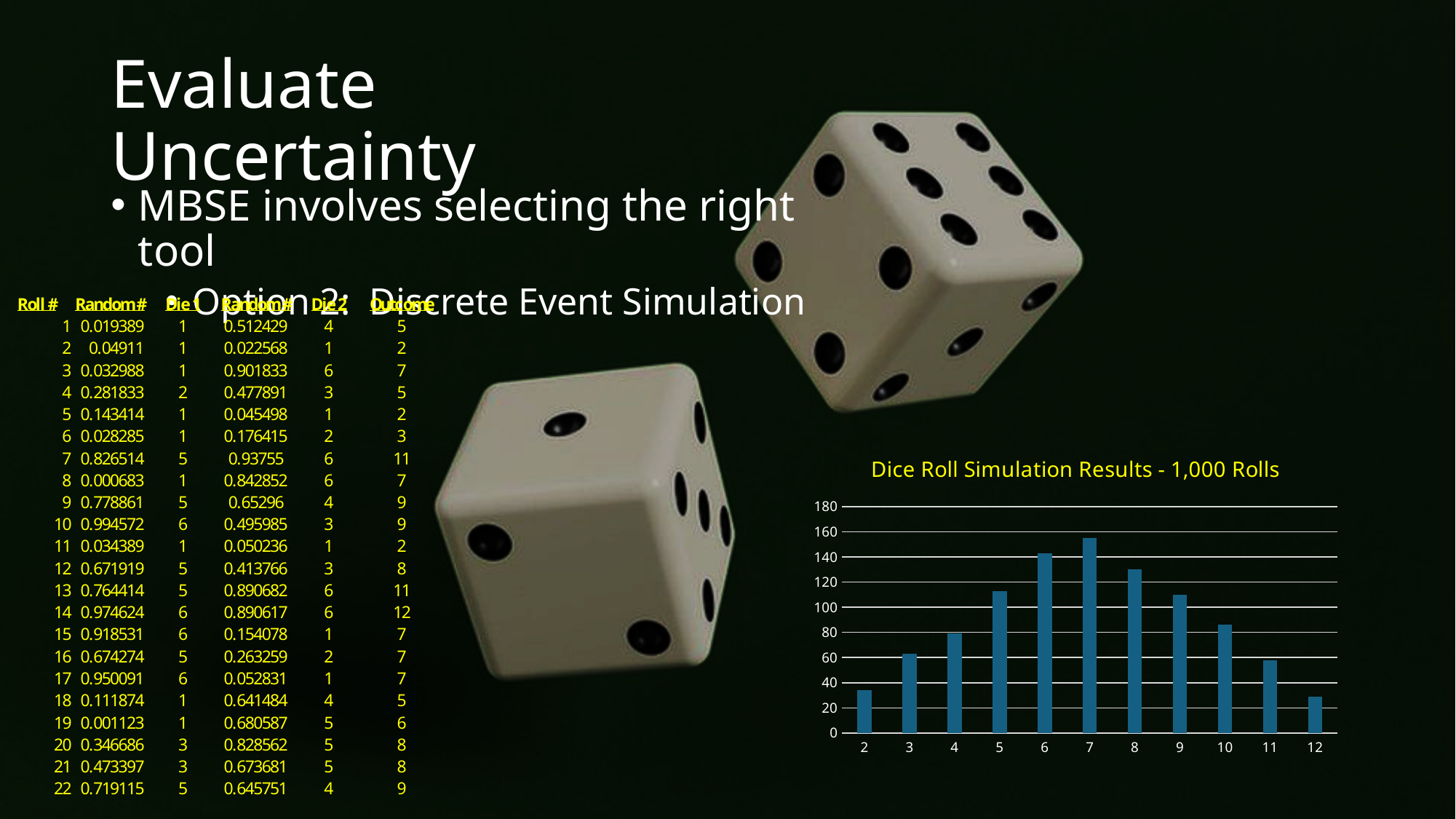
Is the value for outcome 5 greater or less than 100? greater Which has the larger value, outcome 6 or outcome 8? 6 Is the value for outcome 7 greater or less than 140? greater What kind of chart is shown on the slide? bar chart What is the title of the chart? Dice Roll Simulation Results - 1,000 Rolls Is the value for outcome 8 greater or less than 120? greater How many categories (dice outcomes) are plotted on the x axis of the chart? 11 Which outcome has the highest bar in the chart? 7 Which outcome has the lowest bar in the chart? 12 How do the values change along the x axis from outcome 2 to outcome 12? rise to a peak at 7, then fall